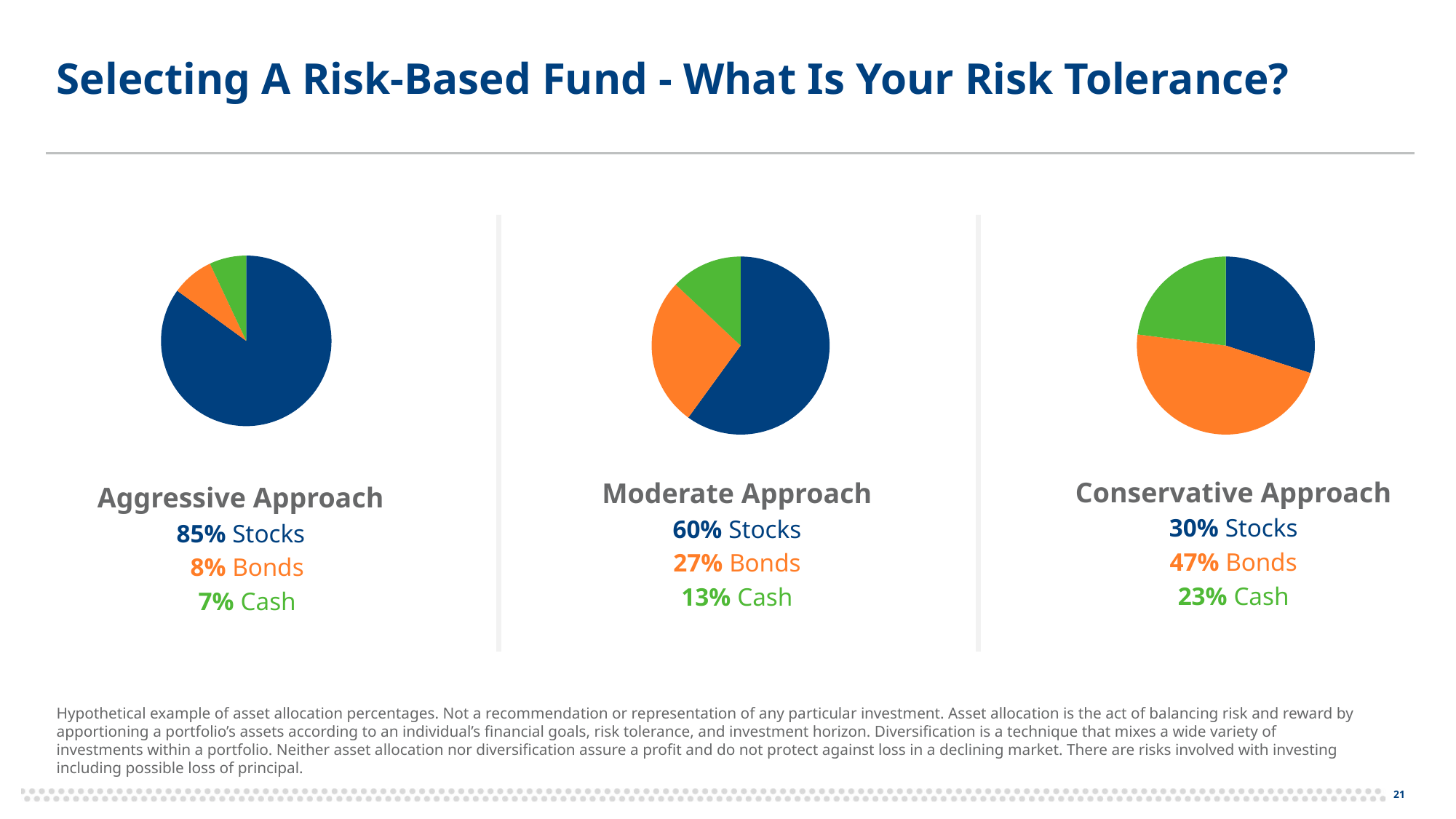
In the Aggressive Approach pie chart, what share is allocated to Stocks? 85% What kind of chart is used for the Aggressive Approach? Pie chart In the Moderate Approach pie chart, what is the difference between the Stocks share and the Bonds share? 33% In the Moderate Approach pie chart, what share is allocated to Bonds? 27% Which colour represents Bonds in the pie charts? Orange In the Aggressive Approach pie chart, which asset class has the smallest share? Cash In the Conservative Approach pie chart, what share is allocated to Cash? 23% In the Conservative Approach pie chart, which asset class has the largest share? Bonds How many pie charts are shown on the slide? 3 In the Conservative Approach pie chart, which is larger, the Stocks share or the Cash share? Stocks How many slices does the Moderate Approach pie chart have? 3 In the Aggressive Approach pie chart, what is the combined share of Bonds and Cash? 15%